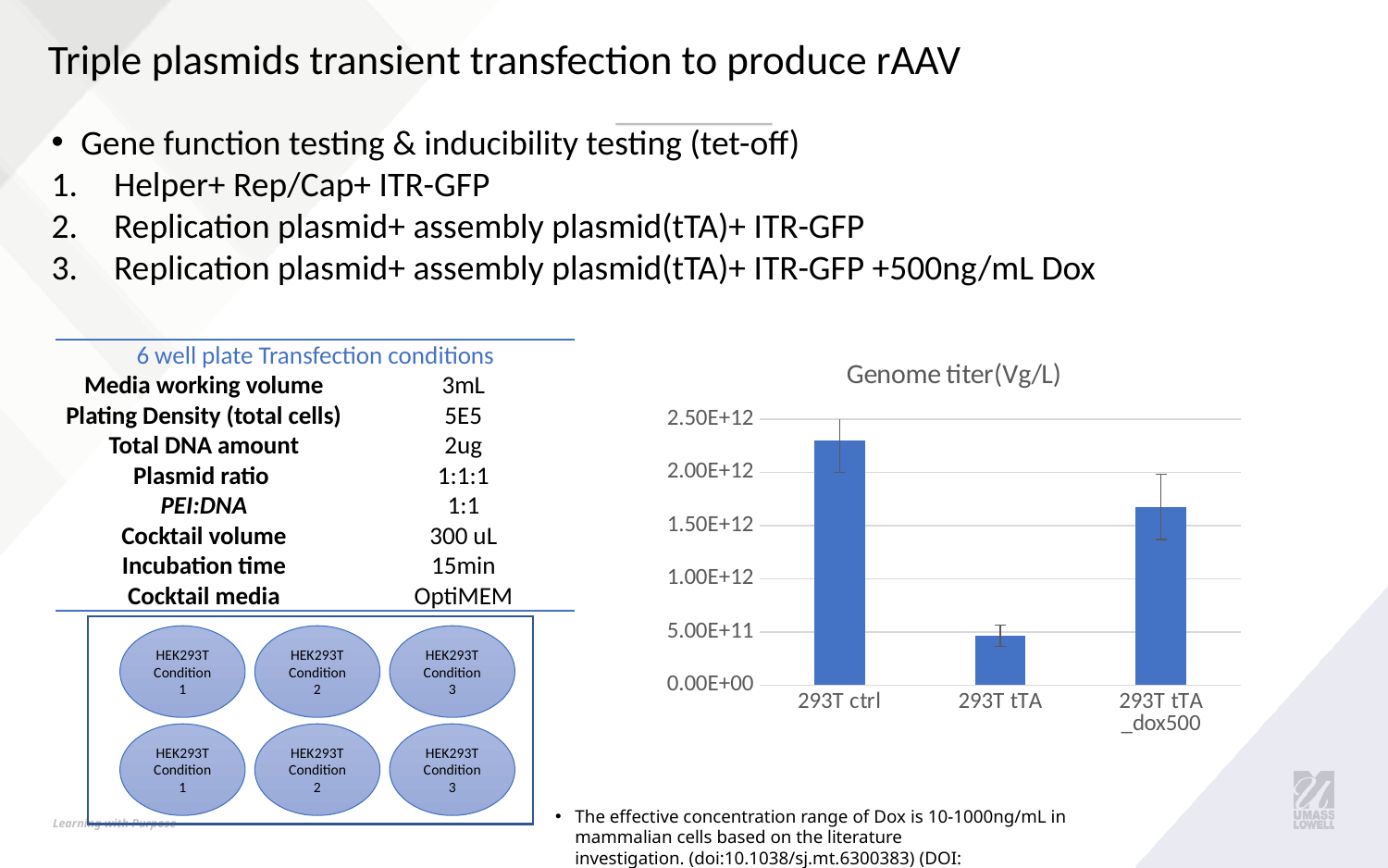
Which has a larger genome titer, 293T ctrl or 293T tTA_dox500? 293T ctrl What type of chart is shown on the slide? bar chart Is the value for 293T ctrl greater or less than 2.00E+12? greater Is the value for 293T tTA_dox500 greater or less than 1.50E+12? greater What is the title of the chart? Genome titer(Vg/L) What is the highest value shown on the y axis of the chart? 2.50E+12 Which category has the highest genome titer? 293T ctrl Which has a larger genome titer, 293T tTA or 293T tTA_dox500? 293T tTA_dox500 Is the value for 293T tTA_dox500 greater or less than 2.00E+12? less How many categories are plotted in the Genome titer chart? 3 Which category has the lowest genome titer? 293T tTA